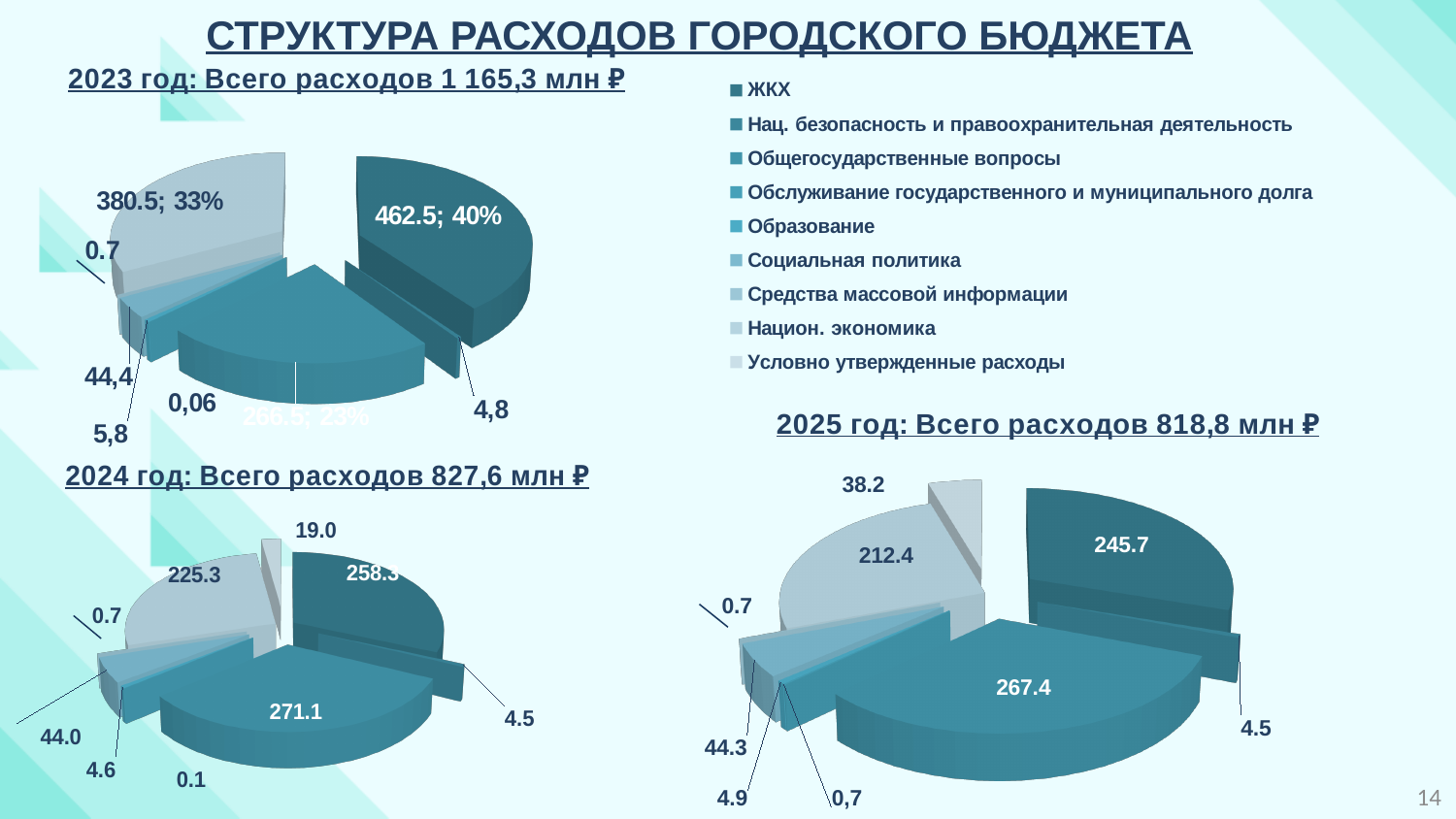
In the 2023 pie chart, what is the value of the largest slice? 462.5 In the 2023 pie chart, what is the smallest labelled value? 0,06 In the 2023 pie chart, what share is shown for the slice labelled 380.5? 33% In the 2025 pie chart, what is the difference between the two largest slices, 267.4 and 245.7? 21.7 In the 2024 pie chart, which is larger: the slice labelled 258.3 or the slice labelled 271.1? 271.1 How many pie charts are on the slide? 3 According to the 2025 chart title, what is the total expenditure for 2025? 818,8 млн ₽ In the 2023 pie chart, what share of the total does the largest slice (462.5) represent? 40% What kind of charts are shown on the slide? pie charts How many categories does the legend list? 9 In the 2024 pie chart, what is the value of the largest slice? 271.1 According to the 2023 chart title, what is the total expenditure for 2023? 1 165,3 млн ₽